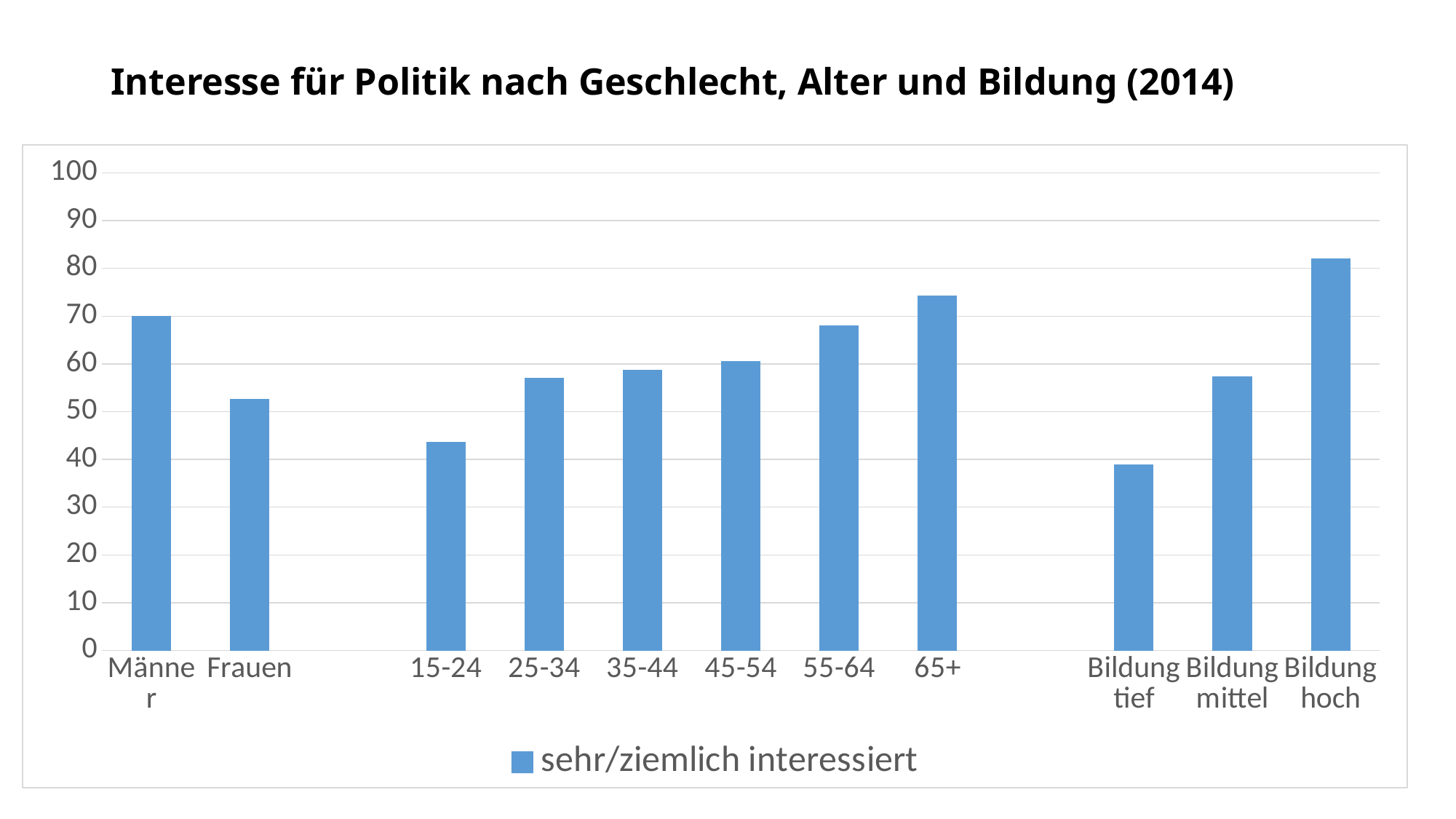
Is the value for 15-24 greater or less than 50? less How many series does the legend list? 1 Which has the larger value, Männer or Frauen? Männer Do the values rise or fall across the age groups from 15-24 to 65+? rise Which category has the lowest value in the chart? Bildung tief What kind of chart is shown on the slide? bar chart Is the value for Männer greater or less than 60? greater How many categories (bars) are plotted in the chart? 11 Is the value for Bildung hoch greater or less than 80? greater What is the title of the chart? Interesse für Politik nach Geschlecht, Alter und Bildung (2014) Which category has the highest value in the chart? Bildung hoch